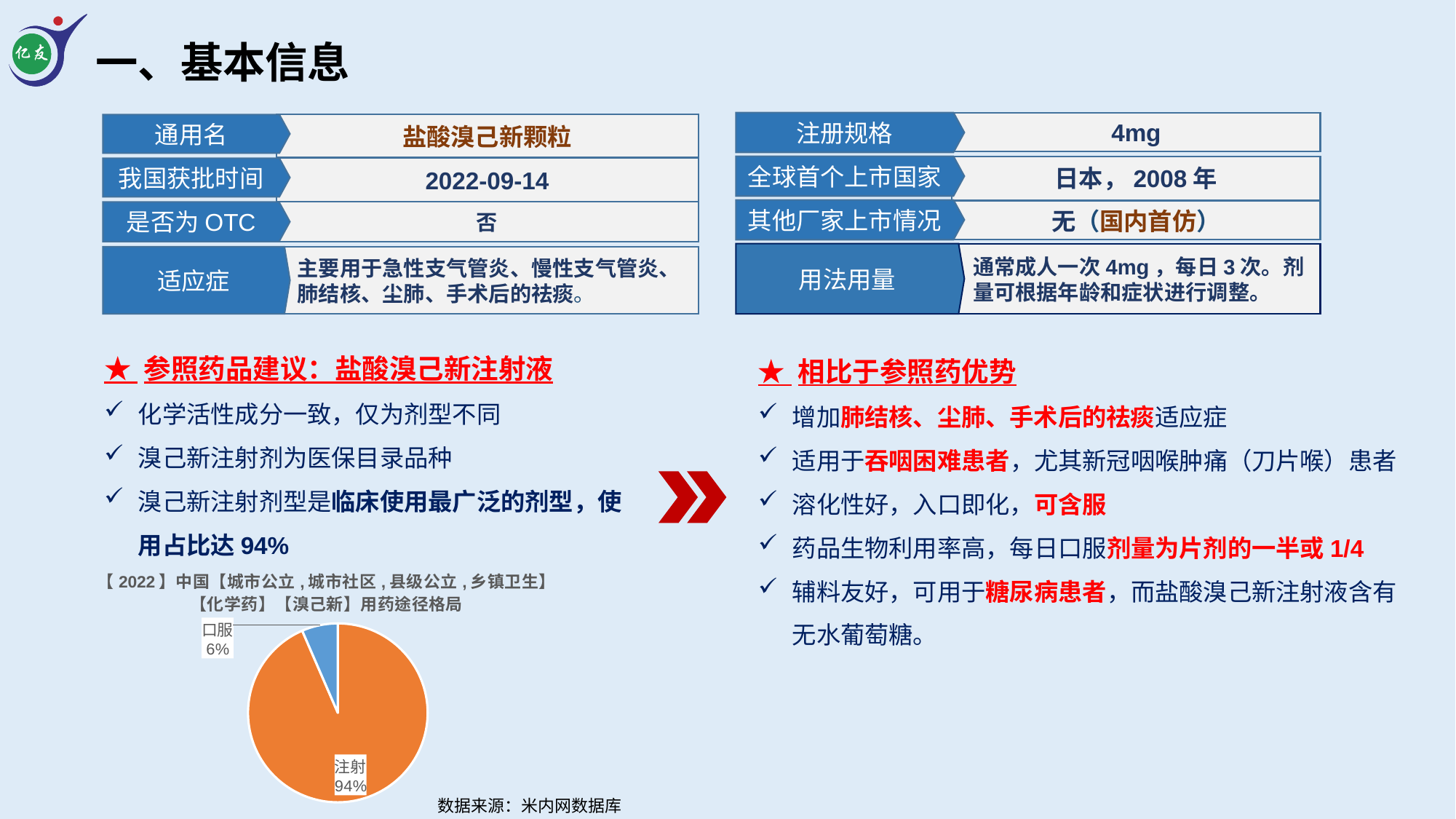
What is the difference in percentage points between the 注射 and 口服 slices? 88 What share of the pie chart does 口服 account for? 6% Which category has the smallest slice in the pie chart? 口服 Which is larger in the pie chart, 口服 or 注射? 注射 Which category has the largest slice in the pie chart? 注射 What share of the pie chart does 注射 account for? 94% What data source is cited below the pie chart? 米内网数据库 What colour is the 注射 slice of the pie chart? orange What kind of chart is shown on the slide? pie chart How many slices does the pie chart have? 2